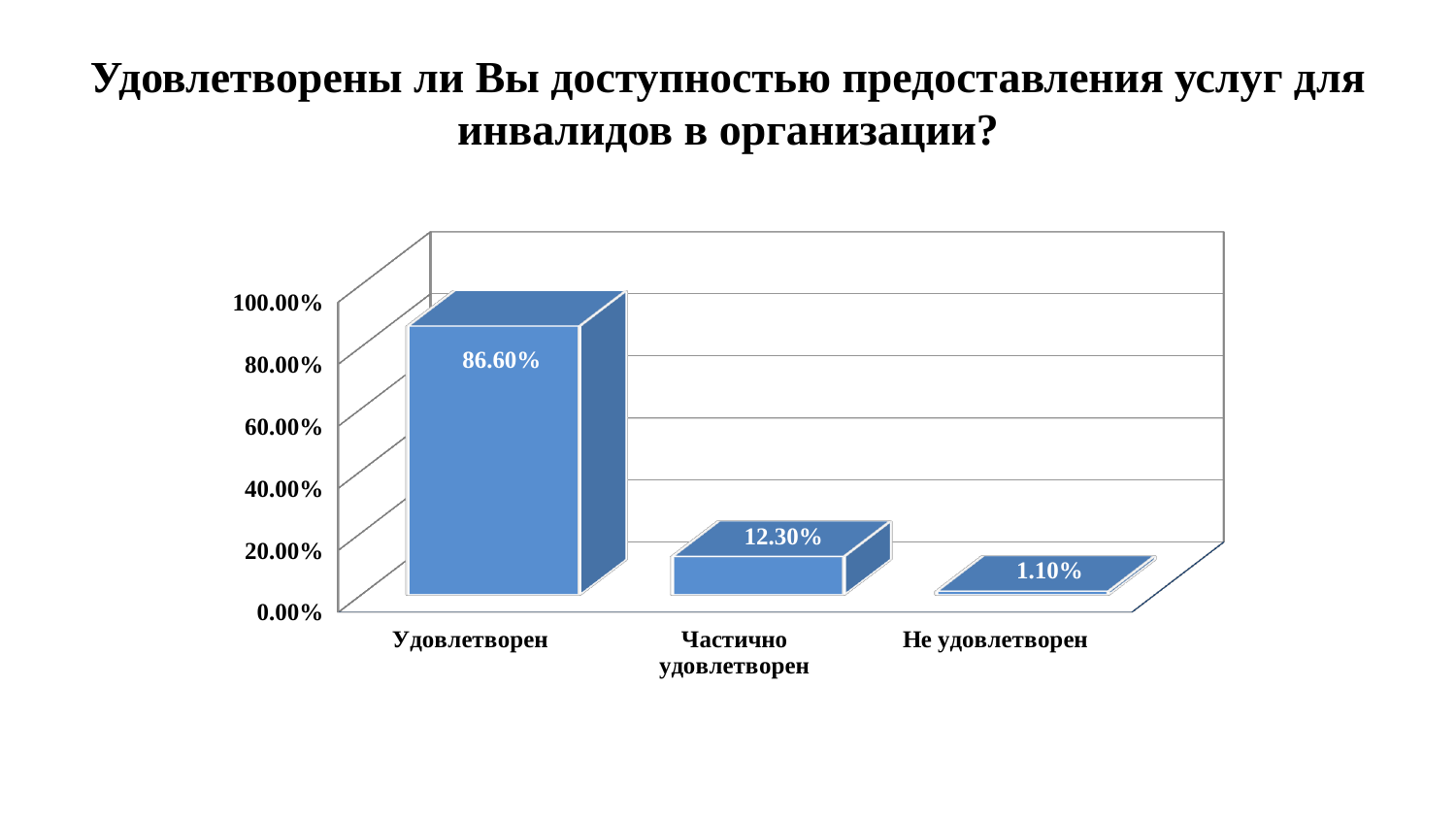
How many categories are shown in the chart? 3 What is the value for Частично удовлетворен? 12.30% What is the value for Удовлетворен? 86.60% Which category has the lowest value? Не удовлетворен What is the value for Не удовлетворен? 1.10% What is the difference between the values for Удовлетворен and Частично удовлетворен? 74.30% Which category has the highest value? Удовлетворен Is the value for Удовлетворен greater or less than 80.00%? greater Which is larger, the value for Частично удовлетворен or the value for Не удовлетворен? Частично удовлетворен Do the values rise or fall from left to right along the x axis? fall What is the difference between the values for Частично удовлетворен and Не удовлетворен? 11.20% What kind of chart is shown on the slide? bar chart